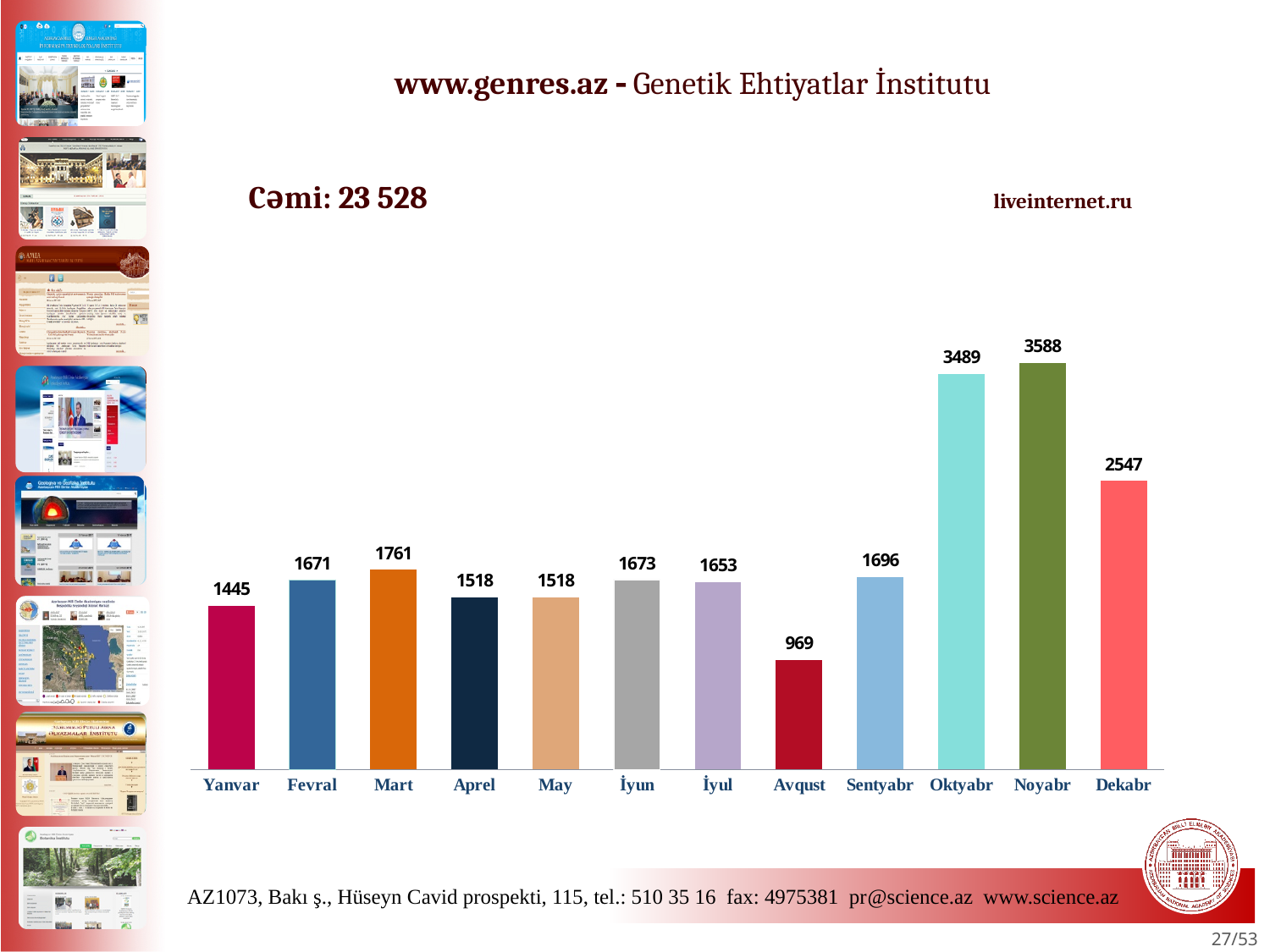
Which month has the lowest value? Avqust What is the difference between the values for Dekabr and Avqust? 1578 What is the value for Noyabr? 3588 What kind of chart is shown on the slide? bar chart What is the value for Dekabr? 2547 What is the value for Avqust? 969 How many months are shown on the x axis? 12 Which two months have the same value of 1518? Aprel and May What is the difference between the values for Noyabr and Oktyabr? 99 Which is larger, the value for Mart or the value for Fevral? Mart Which month has the highest value? Noyabr What total (Cəmi) is stated on the slide? 23 528